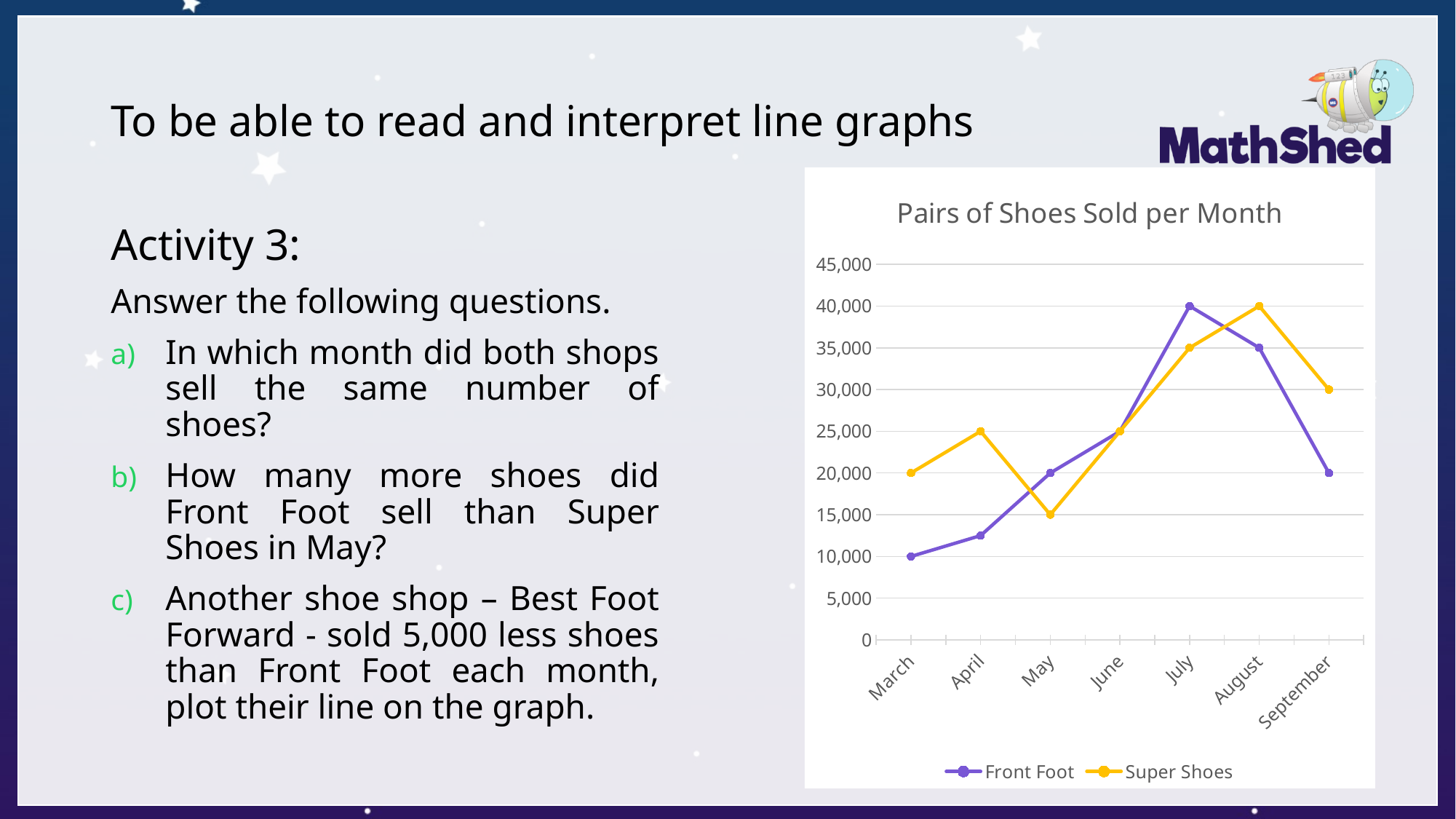
What type of chart is shown on the slide? line chart In which month did Super Shoes sell the most pairs of shoes? August How many pairs of shoes did Super Shoes sell in May? 15,000 How many months are shown on the x axis? 7 Does the Front Foot line rise or fall from March to July? rise Is the value for Front Foot in April greater or less than 15,000? less What is the title of the chart? Pairs of Shoes Sold per Month Which shop sold more pairs of shoes in September, Front Foot or Super Shoes? Super Shoes How many pairs of shoes did Front Foot sell in July? 40,000 How many series does the legend list? 2 In which month did Front Foot sell the fewest pairs of shoes? March How many more pairs of shoes did Front Foot sell than Super Shoes in May? 5,000